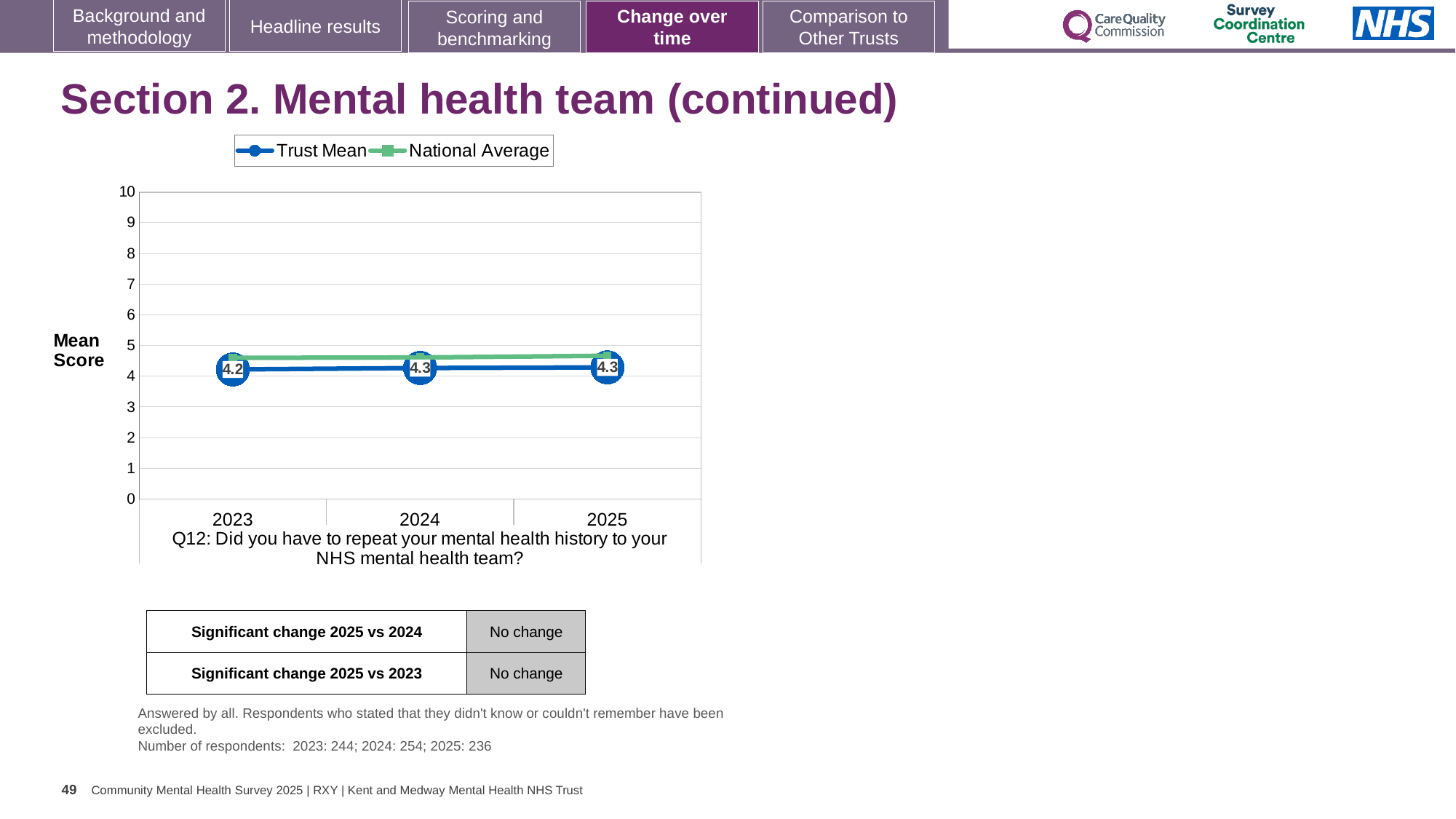
What is the Trust Mean score for 2024? 4.3 What kind of chart is shown on the slide? line chart What is the difference between the Trust Mean score in 2025 and in 2023? 0.1 How many years are plotted on the x axis? 3 Is the National Average value for 2023 greater or less than 6? less What is the Trust Mean score for 2025? 4.3 In which year is the Trust Mean score lowest? 2023 What is the label on the y axis of the chart? Mean Score Is the National Average value for 2025 greater or less than 4? greater How many series does the legend list? 2 What is the Trust Mean score for 2023? 4.2 Which is larger, the Trust Mean score for 2023 or for 2024? 2024